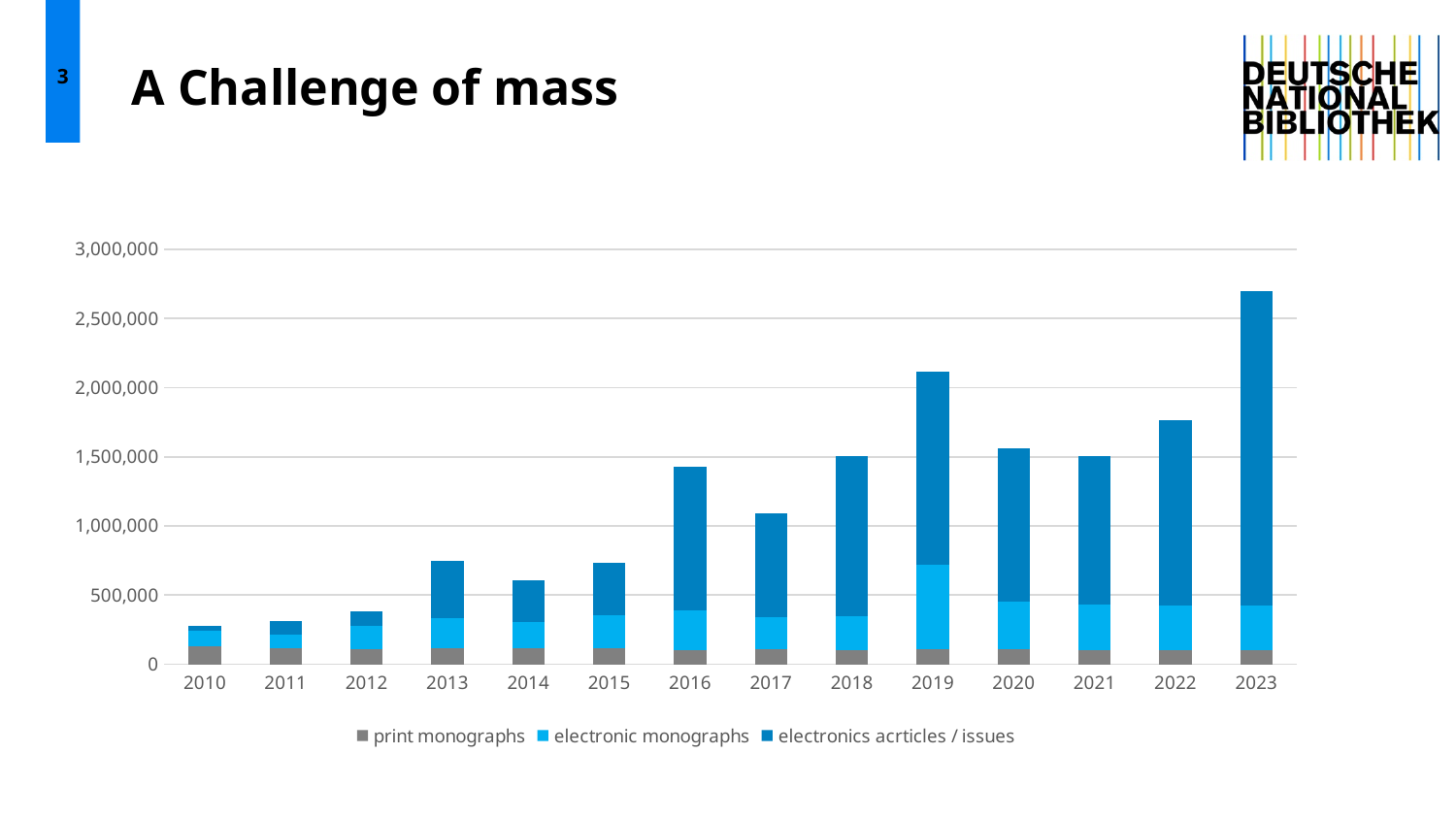
How many years are shown on the x axis of the chart? 14 What kind of chart is shown on the slide? stacked bar chart How many series does the chart's legend list? 3 Is the total stacked value for 2016 greater or less than 1,000,000? greater Is the total stacked value for 2022 greater or less than 2,000,000? less Do the total stacked values generally rise or fall from 2010 to 2023? rise Is the total stacked value for 2010 greater or less than 500,000? less Which year has the larger total stacked bar, 2019 or 2020? 2019 Which series is shown in grey at the bottom of each stacked bar? print monographs Which year has the tallest stacked bar in the chart? 2023 Which year has the shortest stacked bar in the chart? 2010